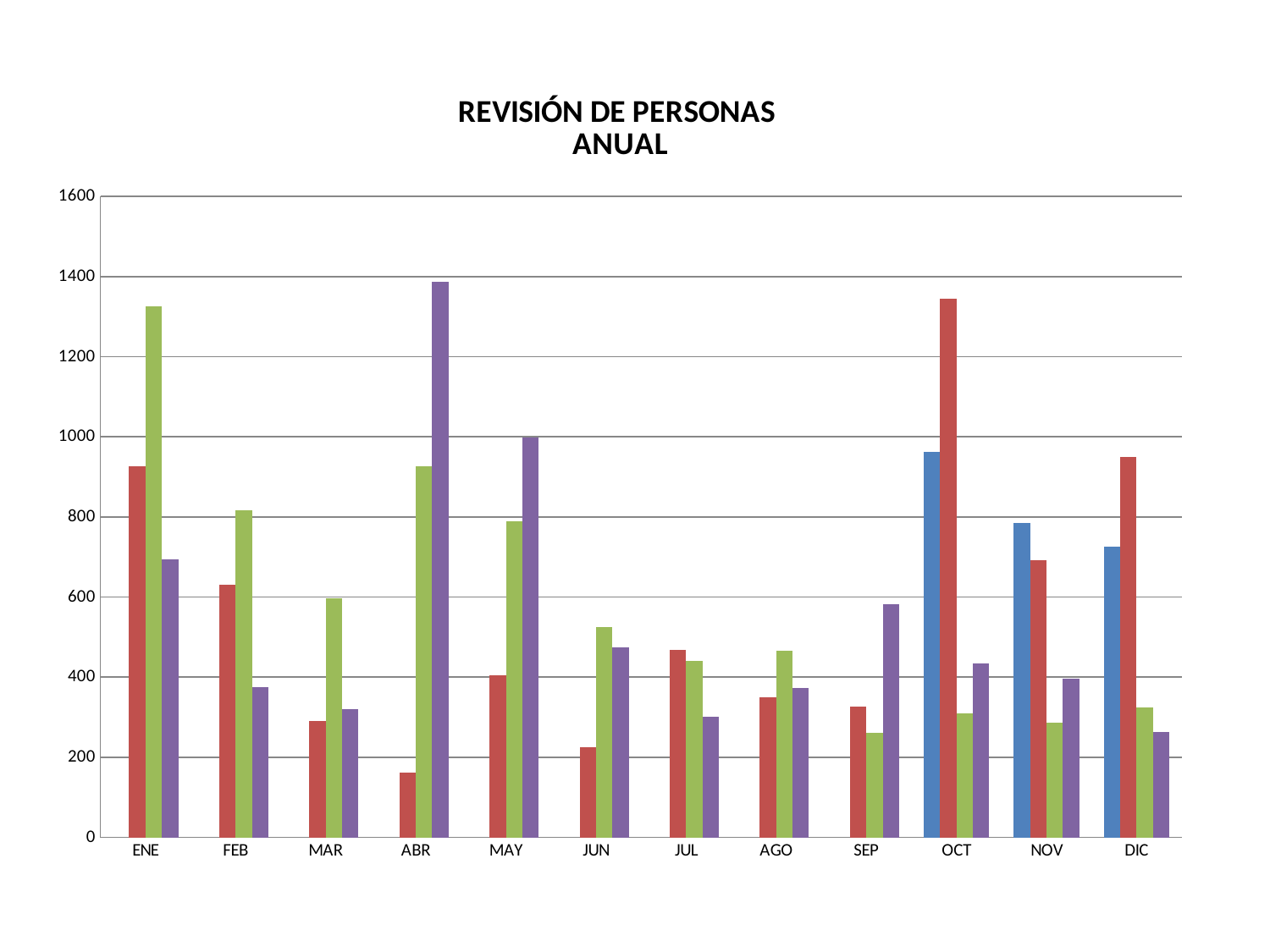
In which month is the purple bar the tallest? ABR In which month is the red bar the tallest? OCT Is the value of the green bar for ENE greater or less than 1200? greater How many months are shown along the x axis of the chart? 12 For MAY, which is larger: the green bar or the purple bar? the purple bar In which month is the green bar the tallest? ENE Is the value of the purple bar for ABR greater or less than 1200? greater In which month is the red bar the shortest? ABR Is the value of the red bar for ABR greater or less than 200? less What is the title of the chart? REVISIÓN DE PERSONAS ANUAL What kind of chart is shown on the slide? bar chart